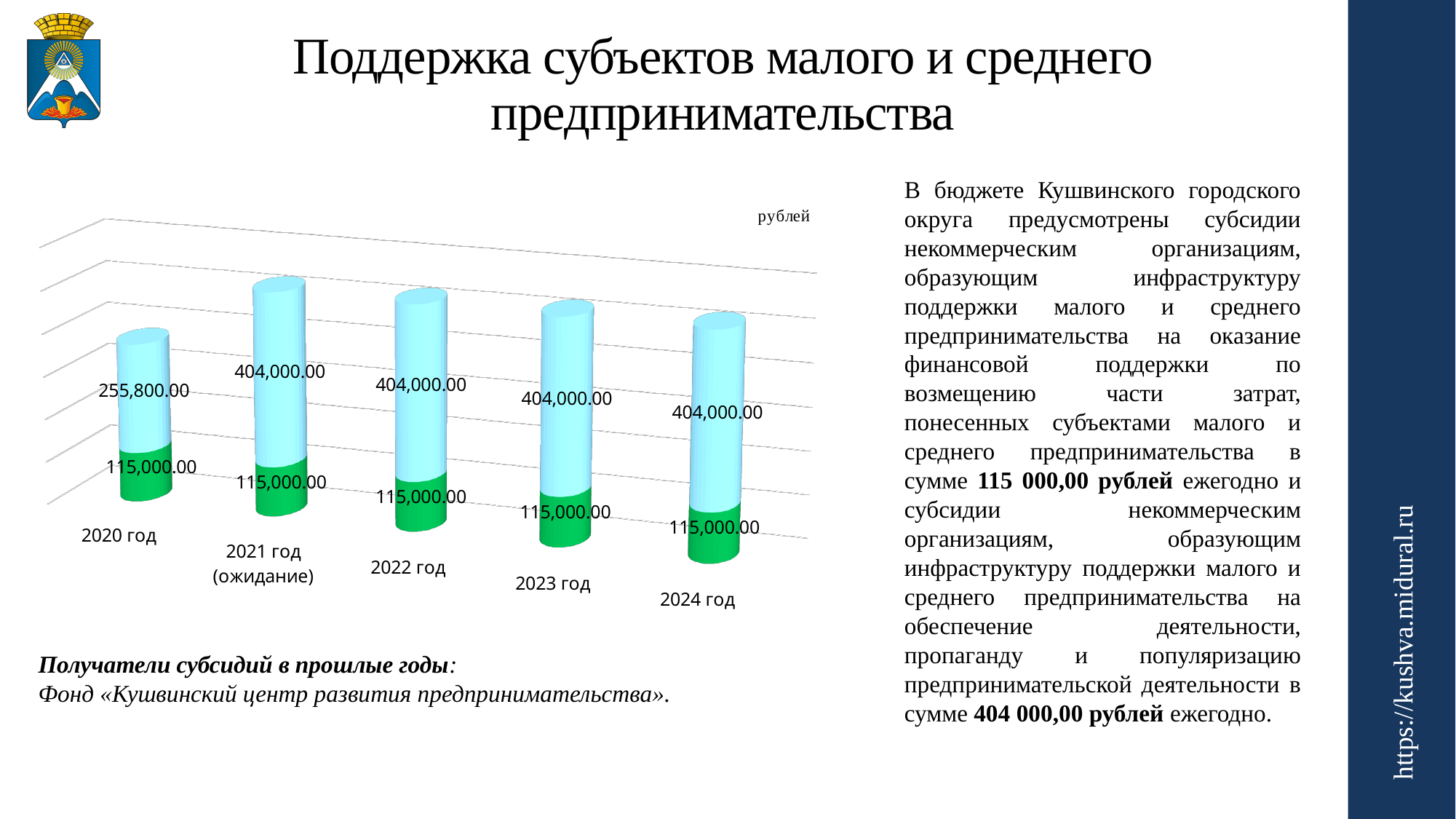
What unit is indicated in the top right corner of the chart? рублей What is the value of the light blue (top) segment for 2020 год? 255,800.00 What kind of chart is shown on the slide? bar chart What is the value of the light blue (top) segment for 2023 год? 404,000.00 What is the total of the stacked bar for 2020 год? 370,800.00 What is the total of the stacked bar for 2023 год? 519,000.00 Which year has the lowest value for the light blue (top) segment? 2020 год What is the value of the green (bottom) segment for 2024 год? 115,000.00 Is the light blue segment value for 2022 год larger or smaller than for 2020 год? larger What is the value of the green (bottom) segment for 2020 год? 115,000.00 How many years (categories) are shown on the chart? 5 What is the difference between the light blue segment values for 2021 год (ожидание) and 2020 год? 148,200.00